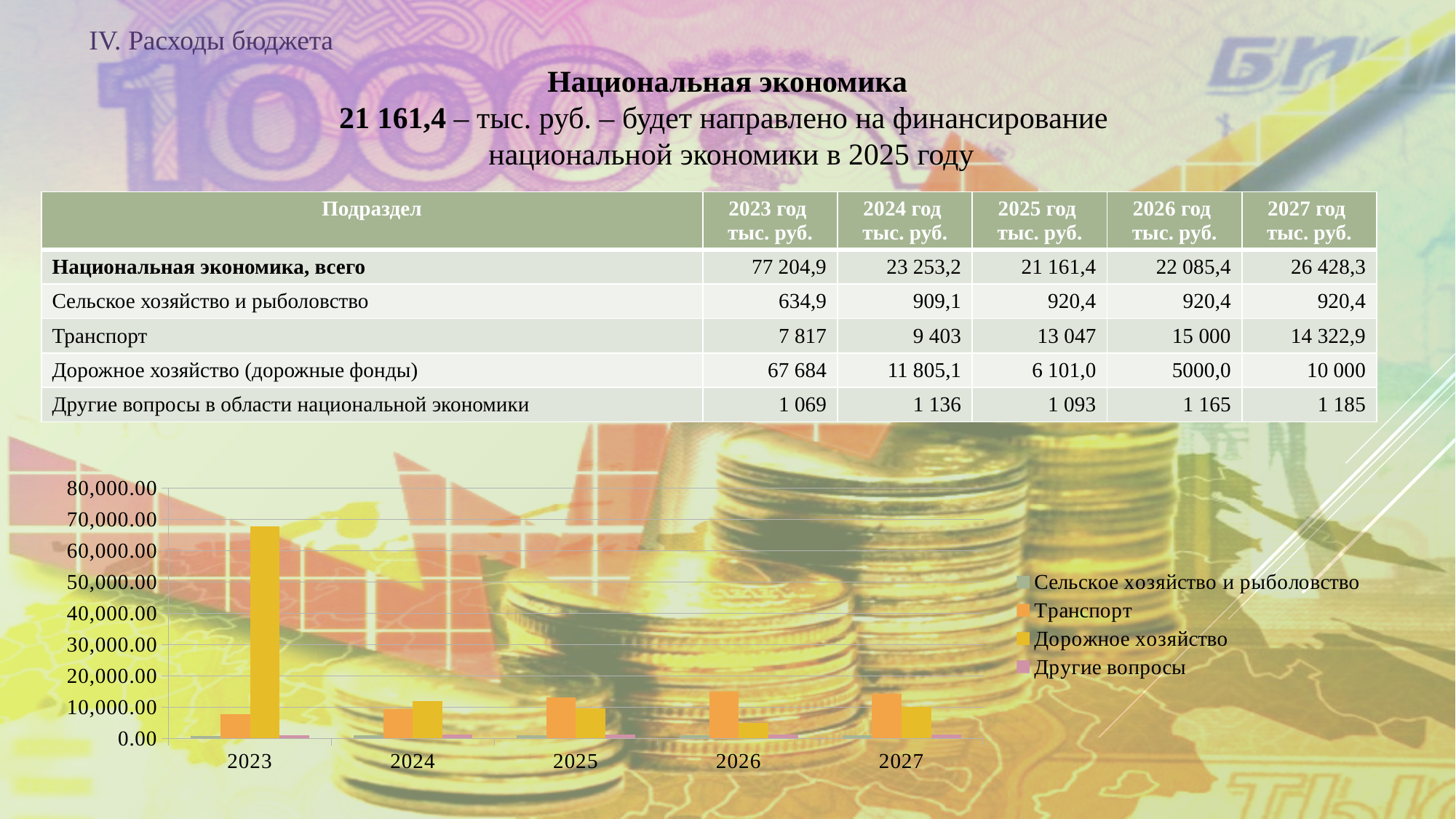
Do the Транспорт bars rise or fall from 2023 to 2026? rise Is the value for Транспорт in 2026 greater or less than 10,000.00? greater In 2024, which is larger: Транспорт or Дорожное хозяйство? Дорожное хозяйство Is the value for Дорожное хозяйство in 2023 greater or less than 60,000.00? greater In which year is the Дорожное хозяйство bar the highest? 2023 How many series does the chart legend list? 4 What colour represents Транспорт in the chart legend? orange How many years are shown on the x axis of the chart? 5 Is the value for Дорожное хозяйство in 2026 greater or less than 10,000.00? less According to the table, what is the value for Транспорт in 2026 (тыс. руб.)? 15 000 What kind of chart is shown at the bottom of the slide? bar chart In 2025, which is larger: Транспорт or Дорожное хозяйство? Транспорт